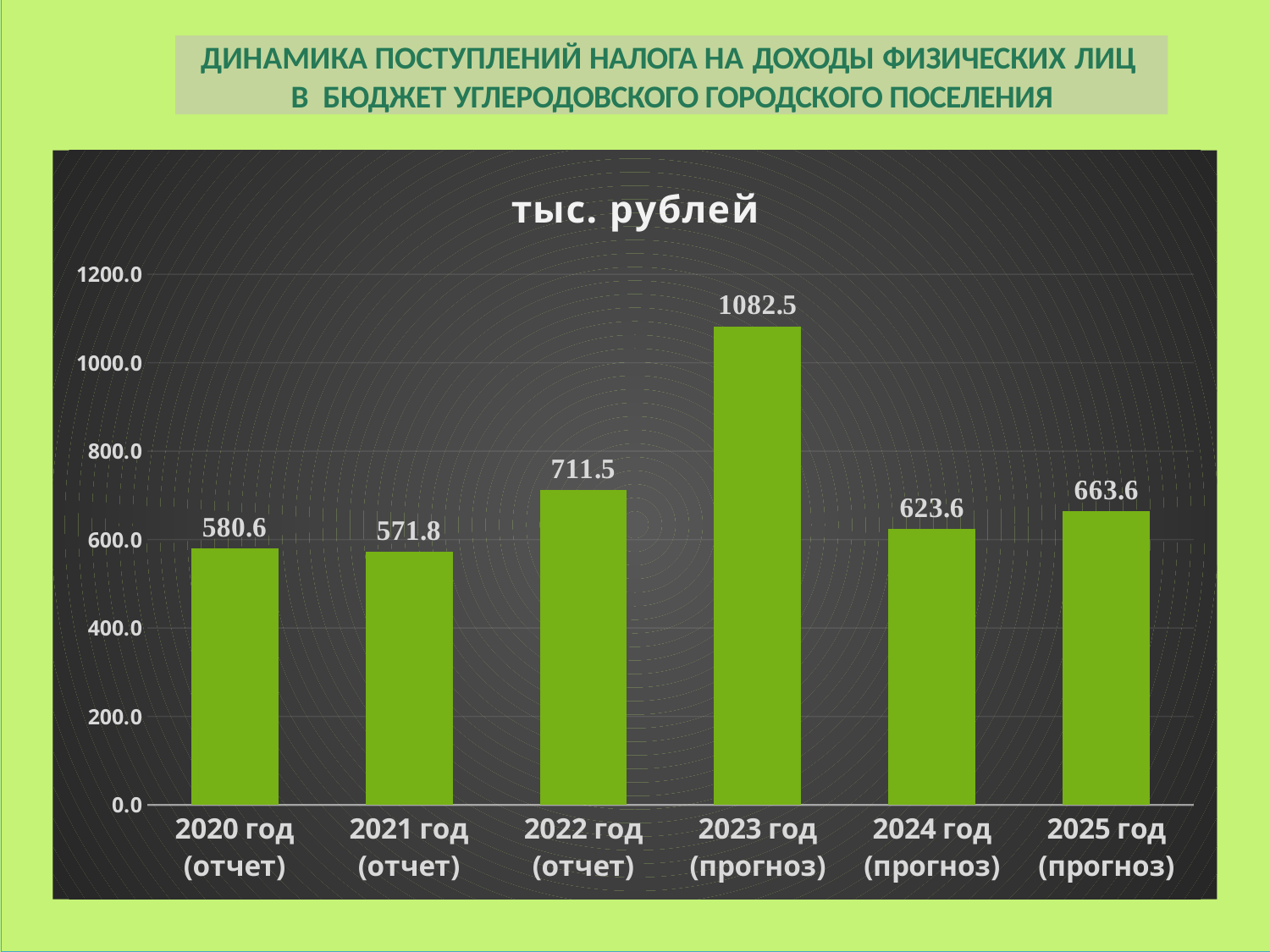
Which is larger, the value for 2022 год (отчет) or the value for 2024 год (прогноз)? 2022 год (отчет) What is the title shown inside the chart area? тыс. рублей What is the value for 2023 год (прогноз)? 1082.5 What is the value for 2020 год (отчет)? 580.6 What is the difference between the values for 2023 год (прогноз) and 2022 год (отчет)? 371.0 What kind of chart is shown on the slide? bar chart What is the value for 2025 год (прогноз)? 663.6 Which year has the highest value? 2023 год (прогноз) What is the difference between the values for 2025 год (прогноз) and 2024 год (прогноз)? 40.0 How many years are shown on the x axis? 6 Is the value for 2022 год (отчет) greater or less than 800.0? less Which year has the lowest value? 2021 год (отчет)